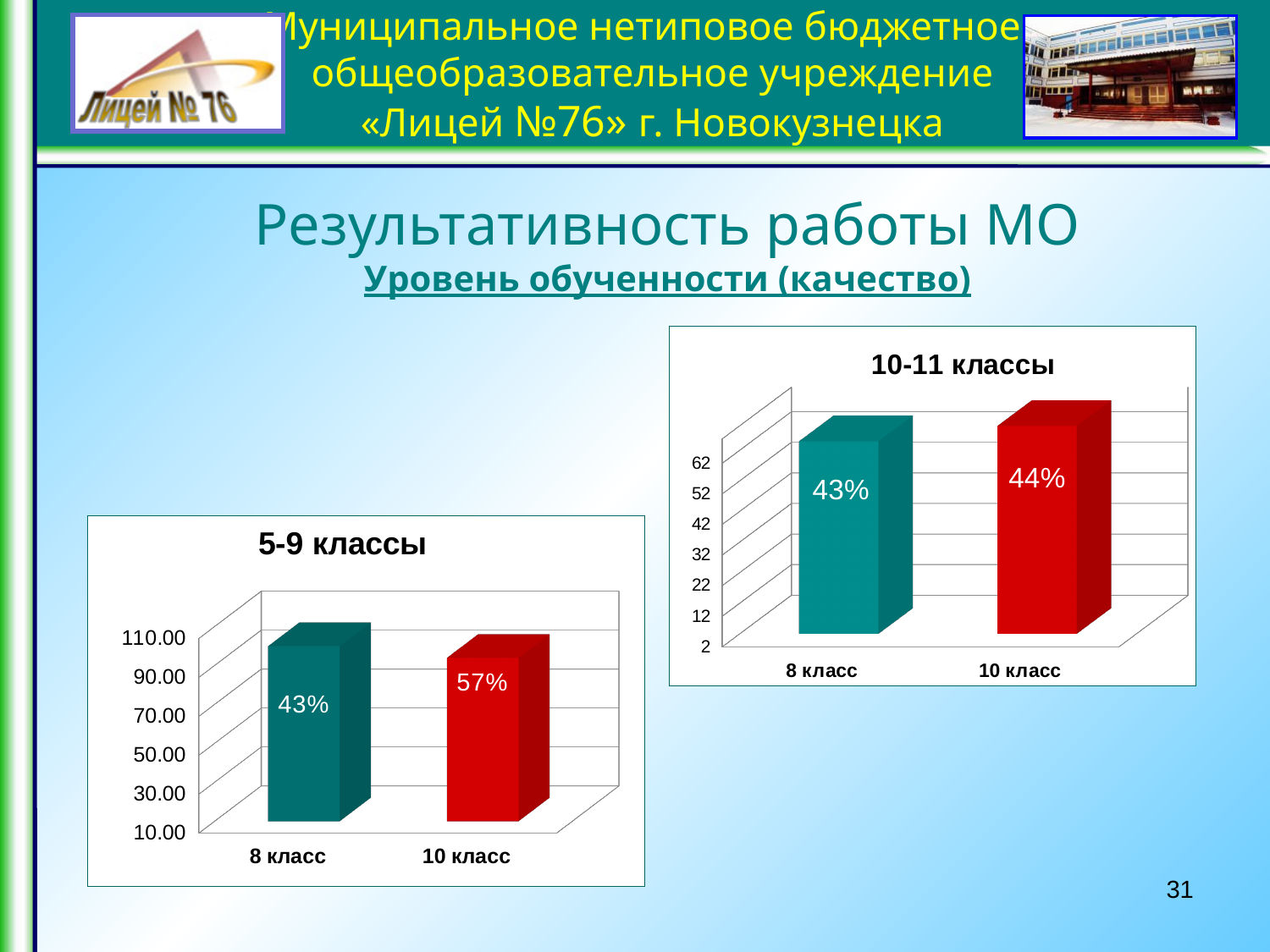
In the chart titled "10-11 классы", which category has the lowest value? 8 класс What kind of chart is the chart titled "10-11 классы"? Bar chart In the chart titled "5-9 классы", what is the value for 10 класс? 57% In the chart titled "10-11 классы", what is the value for 8 класс? 43% In the chart titled "5-9 классы", what is the value for 8 класс? 43% In the chart titled "10-11 классы", what is the value for 10 класс? 44% What colour is the bar for 10 класс in the chart titled "5-9 классы"? Red In the chart titled "10-11 классы", which is larger: the value for 8 класс or for 10 класс? 10 класс How many categories are shown in the chart titled "5-9 классы"? 2 In the chart titled "10-11 классы", what is the difference between the values for 10 класс and 8 класс? 1 percentage point